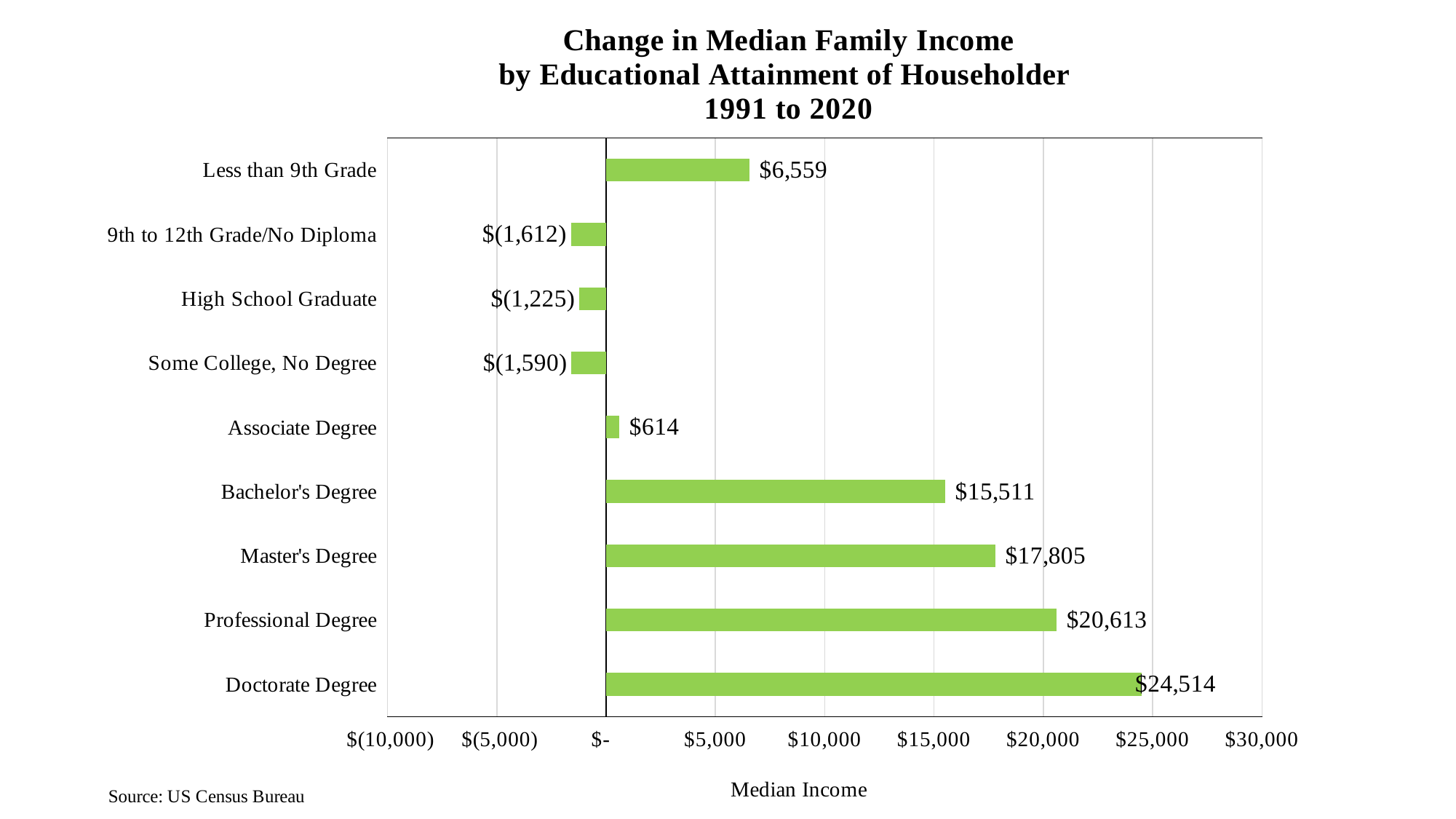
What is the difference between the values for Professional Degree and Master's Degree? $2,808 Which is larger, the value for Bachelor's Degree or the value for Less than 9th Grade? Bachelor's Degree How many educational attainment categories are shown in the chart? 9 What is the change in median family income for householders with a Doctorate Degree? $24,514 What type of chart is shown on the slide? Bar chart Which educational attainment category has the lowest change in median family income? 9th to 12th Grade/No Diploma Is the value for Master's Degree greater or less than $15,000? greater What is the value shown for Associate Degree? $614 Which educational attainment category has the highest change in median family income? Doctorate Degree What is the source cited for the chart data? US Census Bureau How many categories show a negative change in median family income? 3 What is the value shown for High School Graduate? $(1,225)